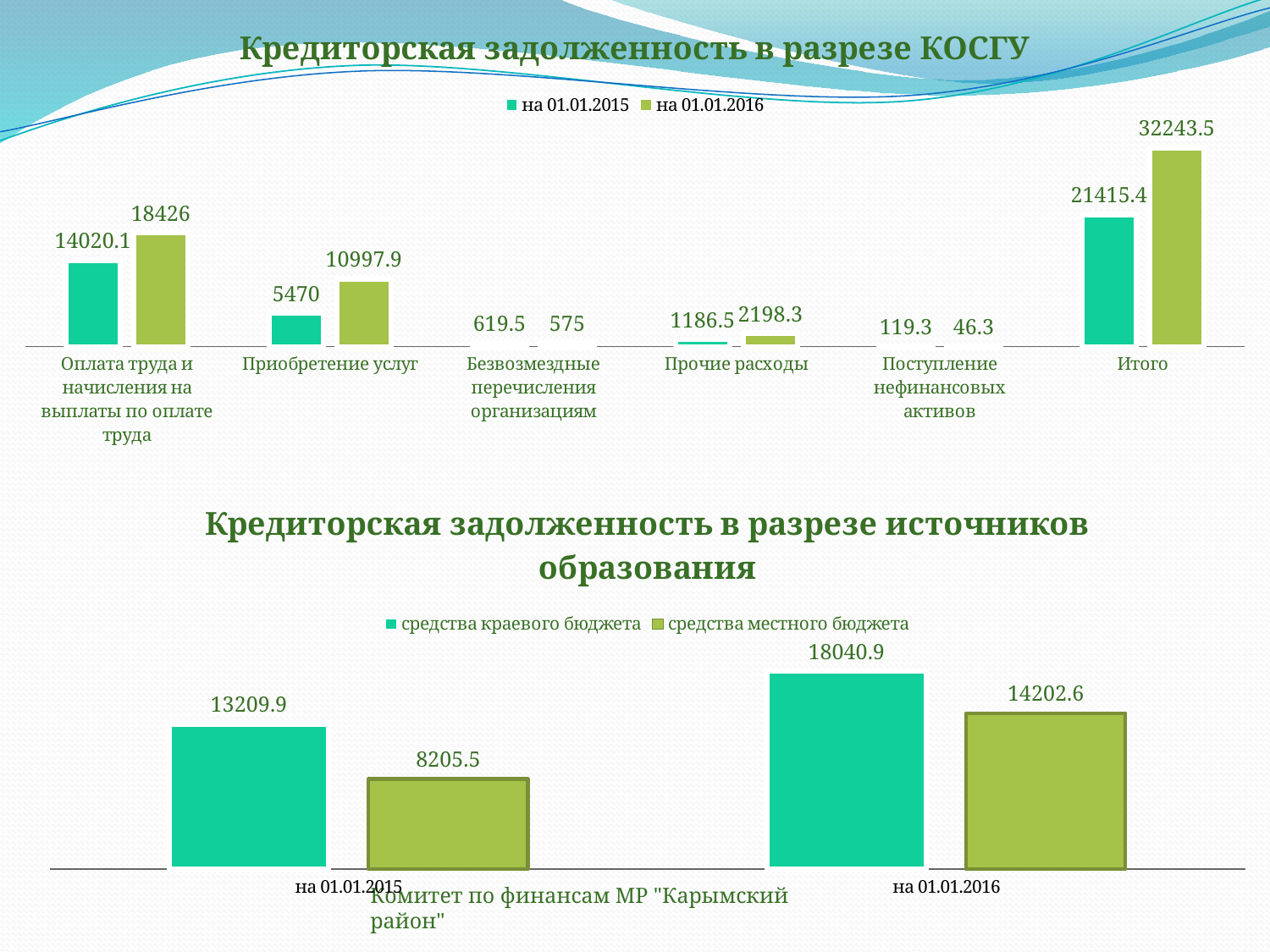
How many categories are shown on the x axis of the top chart 'Кредиторская задолженность в разрезе КОСГУ'? 6 In the top chart 'Кредиторская задолженность в разрезе КОСГУ', what is the value for 'Приобретение услуг' for the series 'на 01.01.2016'? 10997.9 In the top chart 'Кредиторская задолженность в разрезе КОСГУ', excluding 'Итого', which category has the highest value for 'на 01.01.2015'? Оплата труда и начисления на выплаты по оплате труда In the bottom chart 'Кредиторская задолженность в разрезе источников образования', what is the value for 'средства местного бюджета' on 'на 01.01.2015'? 8205.5 In the top chart 'Кредиторская задолженность в разрезе КОСГУ', for 'Безвозмездные перечисления организациям', which series has the larger value: 'на 01.01.2015' or 'на 01.01.2016'? на 01.01.2015 In the top chart 'Кредиторская задолженность в разрезе КОСГУ', which category has the lowest value for 'на 01.01.2016'? Поступление нефинансовых активов In the top chart 'Кредиторская задолженность в разрезе КОСГУ', what is the value for 'Итого' for the series 'на 01.01.2016'? 32243.5 In the top chart 'Кредиторская задолженность в разрезе КОСГУ', what is the value for 'Поступление нефинансовых активов' for the series 'на 01.01.2015'? 119.3 What kind of chart is the bottom chart 'Кредиторская задолженность в разрезе источников образования'? Bar chart In the top chart 'Кредиторская задолженность в разрезе КОСГУ', what is the difference between the 'на 01.01.2016' and 'на 01.01.2015' values for 'Прочие расходы'? 1011.8 How many series does the legend of the top chart 'Кредиторская задолженность в разрезе КОСГУ' list? 2 In the bottom chart 'Кредиторская задолженность в разрезе источников образования', what is the difference between 'средства краевого бюджета' and 'средства местного бюджета' on 'на 01.01.2016'? 3838.3